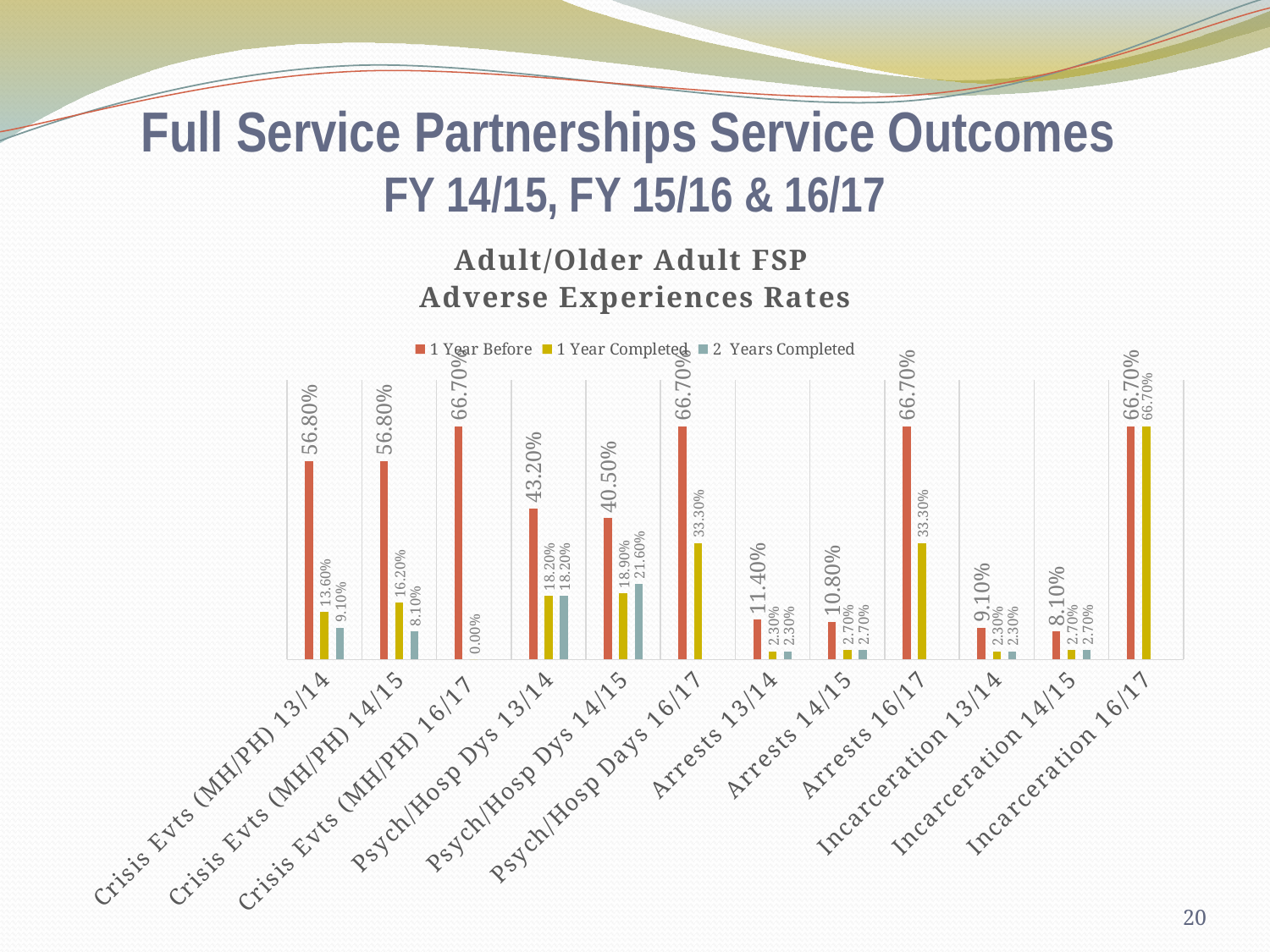
What is the 2 Years Completed value for Psych/Hosp Dys 14/15? 21.60% What is the 1 Year Completed value for Arrests 16/17? 33.30% How many categories are shown on the x axis? 12 How many series does the legend list? 3 What is the 1 Year Before value for Crisis Evts (MH/PH) 13/14? 56.80% Which category has the highest 1 Year Completed value? Incarceration 16/17 Which is larger for Incarceration 14/15: the 1 Year Before value or the 1 Year Completed value? 1 Year Before What is the difference between the 1 Year Before and 1 Year Completed values for Psych/Hosp Dys 13/14? 25.00% What is the 1 Year Completed value for Crisis Evts (MH/PH) 16/17? 0.00% Which category has the lowest 1 Year Before value? Incarceration 14/15 What type of chart is shown on the slide? Bar chart What is the title of the chart? Adult/Older Adult FSP Adverse Experiences Rates